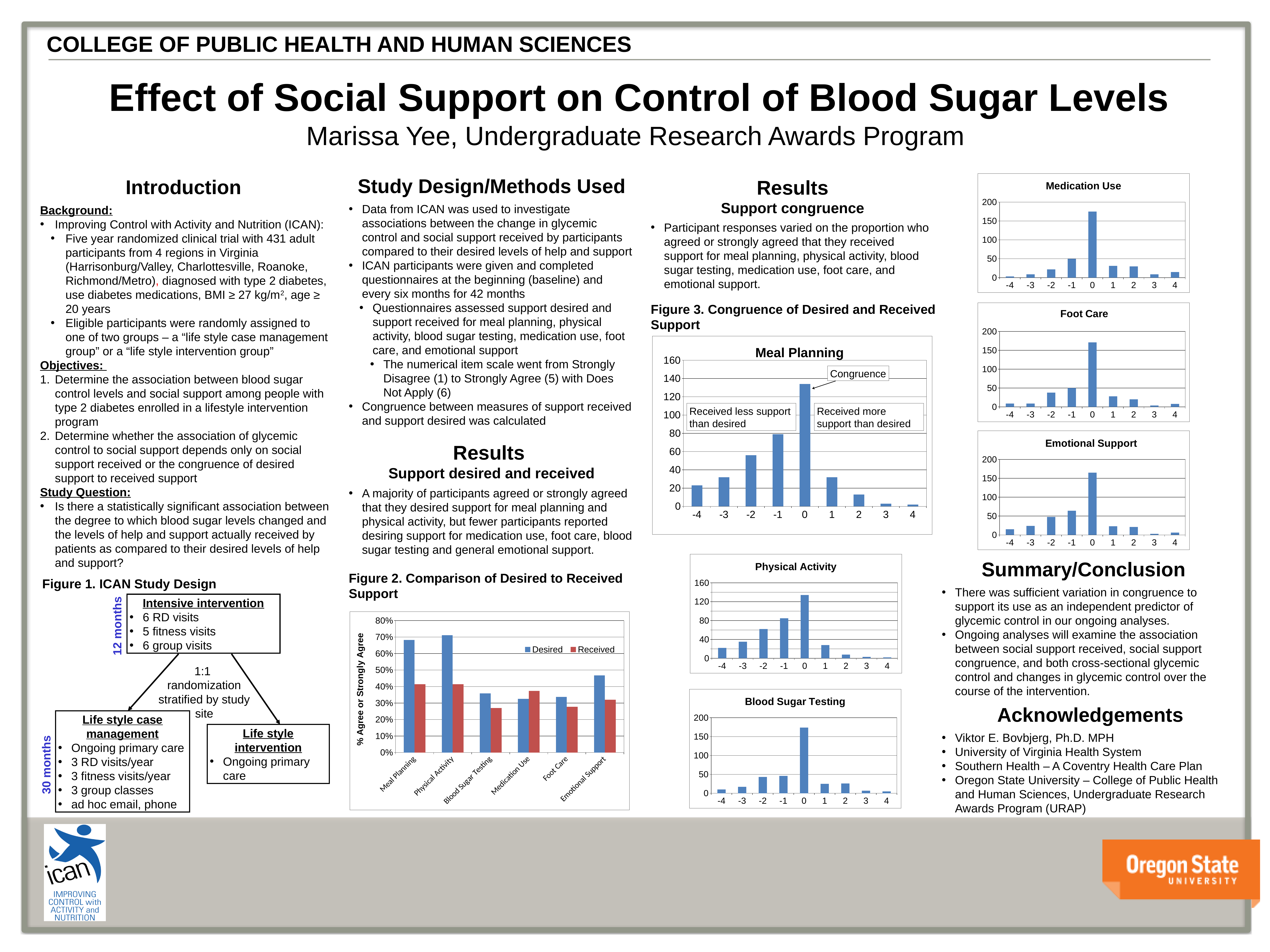
In the Figure 2 chart (Comparison of Desired to Received Support), how many categories are shown on the x axis? 6 In the Figure 2 chart (Comparison of Desired to Received Support), is the Desired value for Meal Planning greater or less than 60%? greater In the Meal Planning chart, which x-axis category has the highest value? 0 In the Figure 2 chart (Comparison of Desired to Received Support), what are the two series named in the legend? Desired and Received What kind of chart is the Meal Planning chart in Figure 3? bar chart In the Blood Sugar Testing chart, how many x-axis categories are shown? 9 In the Medication Use chart, is the value at 0 greater or less than 150? greater In the Figure 2 chart (Comparison of Desired to Received Support), is the Desired value for Emotional Support greater or less than 50%? less In the Figure 2 chart (Comparison of Desired to Received Support), for Medication Use, which is larger: the Desired value or the Received value? Received In the Figure 2 chart (Comparison of Desired to Received Support), how many series does the legend list? 2 In the Meal Planning chart, which is larger: the value at -1 or the value at 1? -1